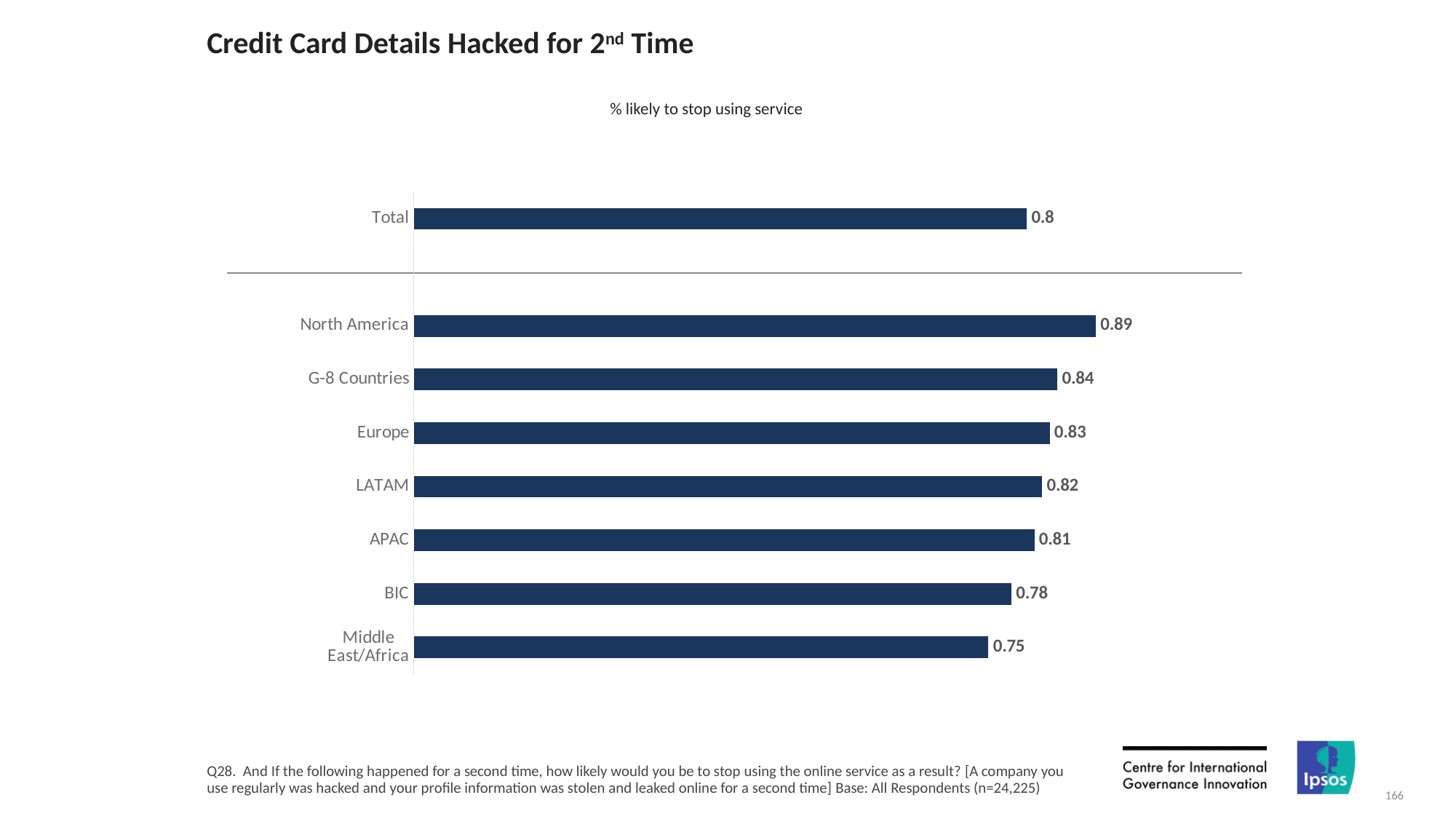
What is the value for Total? 0.8 Which region has the highest value? North America How many bars are shown in the chart? 8 Which region has the lowest value? Middle East/Africa What kind of chart is shown on the slide? Bar chart What is the value for LATAM? 0.82 What is the value for Middle East/Africa? 0.75 What is the difference between the values for North America and Middle East/Africa? 0.14 What is the value for North America? 0.89 What is the subtitle shown above the chart? % likely to stop using service What is the difference between the values for G-8 Countries and BIC? 0.06 Which is larger, the value for Europe or the value for APAC? Europe